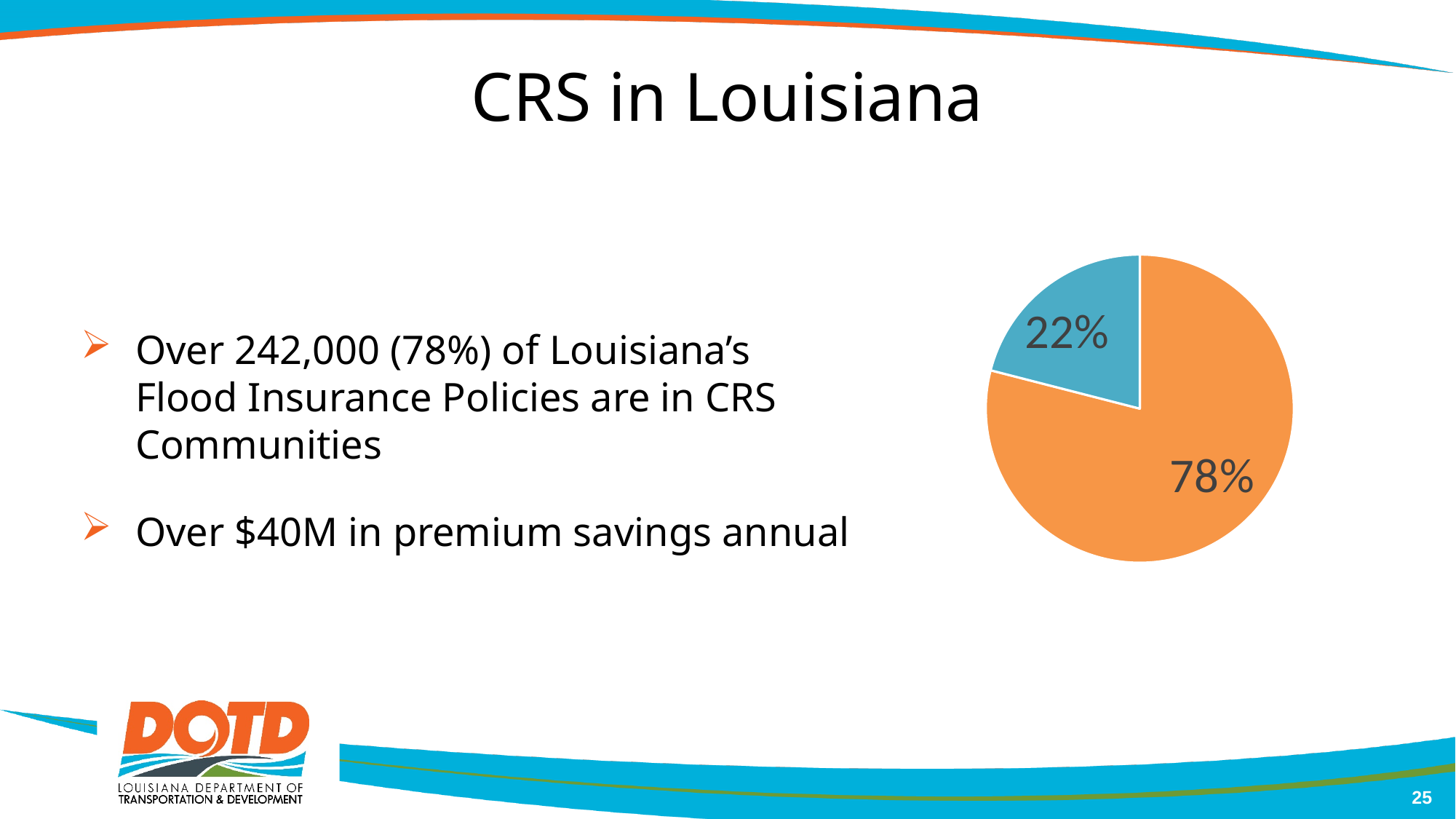
Which slice of the pie chart is the largest? the orange slice (78%) What kind of chart is shown on the slide? pie chart What colour is the slice labelled 78%? orange Which slice of the pie chart is the smallest? the blue slice (22%) Which is larger, the orange slice or the blue slice? the orange slice Does the pie chart have a legend? No What share of the pie does the blue slice represent? 22% What do the two slices of the pie chart add up to? 100% What percentage is shown on the orange slice of the pie chart? 78% What percentage is shown on the blue slice of the pie chart? 22% What is the difference in percentage points between the orange slice and the blue slice? 56 percentage points How many slices does the pie chart have? 2